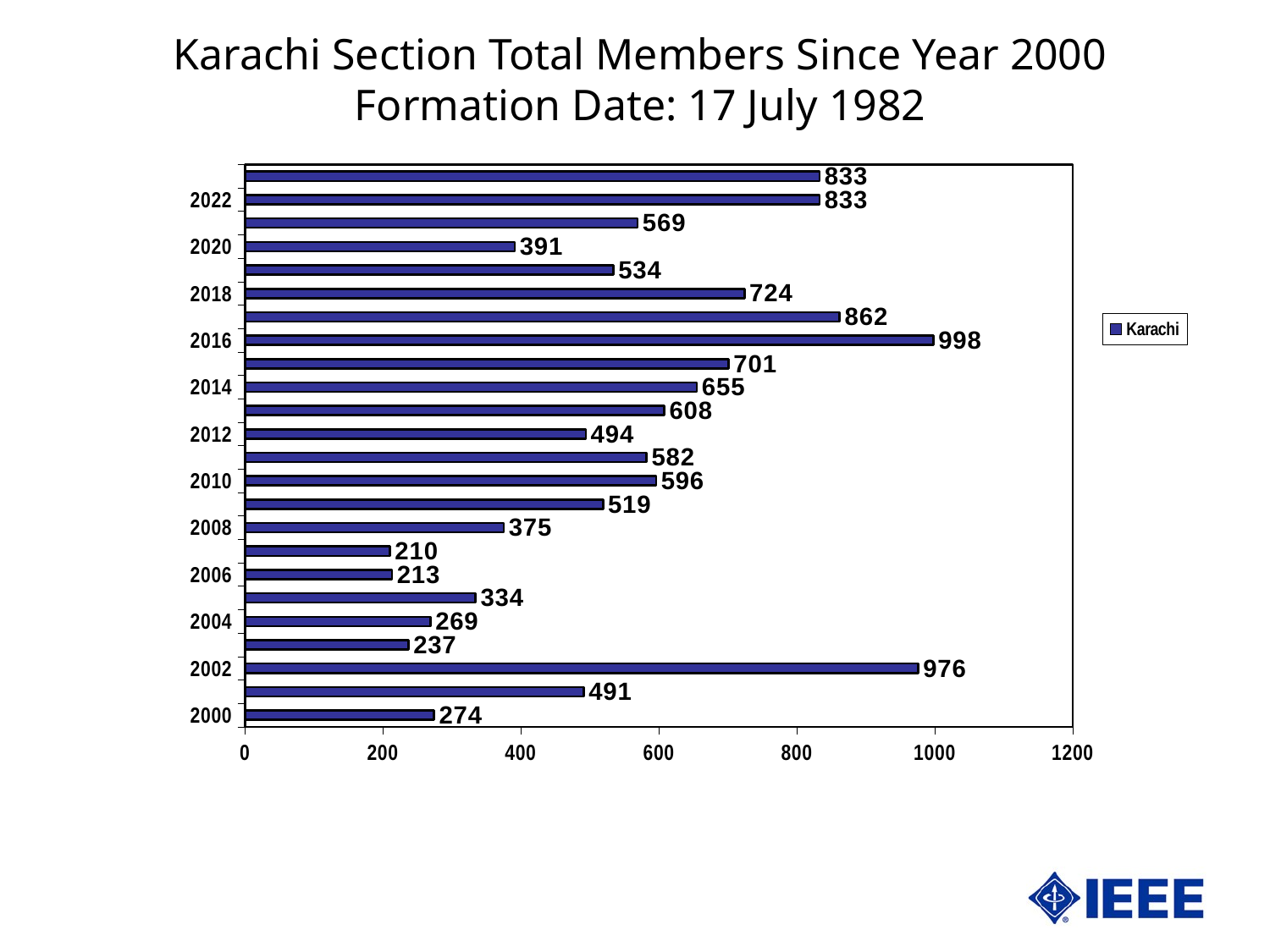
What is the smallest value shown on the chart? 210 Which year has the highest value? 2016 How many bars are plotted on the chart? 24 What is the value for 2022? 833 What series name does the legend show? Karachi What kind of chart is shown? bar chart What is the value for 2016? 998 What is the value for 2002? 976 Which is larger, the value for 2010 or the value for 2020? 2010 What is the value for 2000? 274 Is the value for 2018 greater or less than 600? greater What is the difference between the values for 2016 and 2000? 724